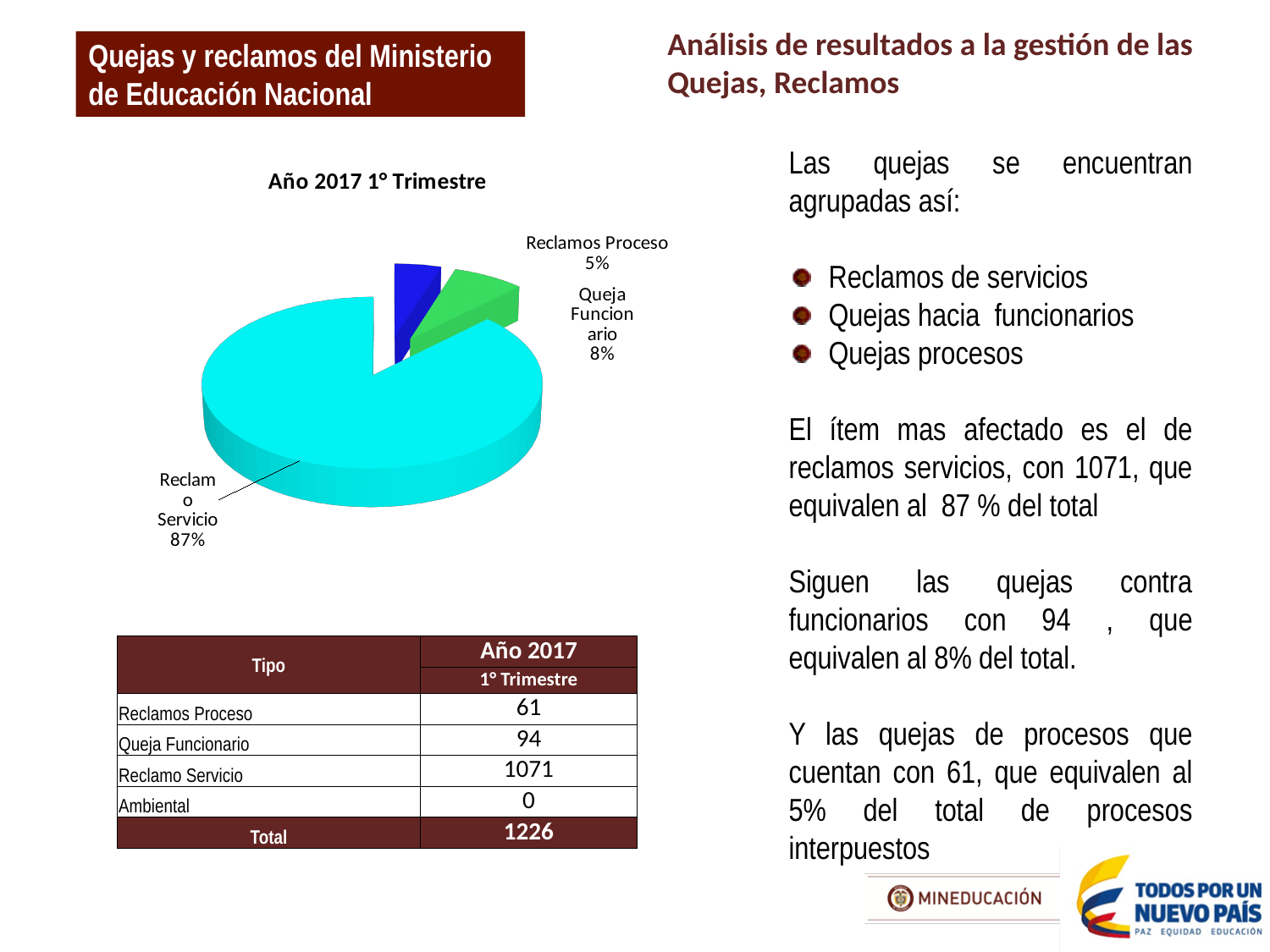
What type of chart is shown on the slide? pie chart What share of the pie does Reclamo Servicio represent? 87% What share of the pie does Reclamos Proceso represent? 5% What share of the pie does Queja Funcionario represent? 8% What is the difference in percentage points between the Reclamo Servicio slice and the Queja Funcionario slice? 79 Which slice is larger, Queja Funcionario or Reclamos Proceso? Queja Funcionario Which category has the largest slice in the pie chart? Reclamo Servicio What is the difference in percentage points between the Queja Funcionario slice and the Reclamos Proceso slice? 3 Which category has the smallest slice in the pie chart? Reclamos Proceso What colour is the Reclamo Servicio slice in the pie chart? cyan How many slices does the pie chart have? 3 What is the title of the pie chart? Año 2017 1° Trimestre